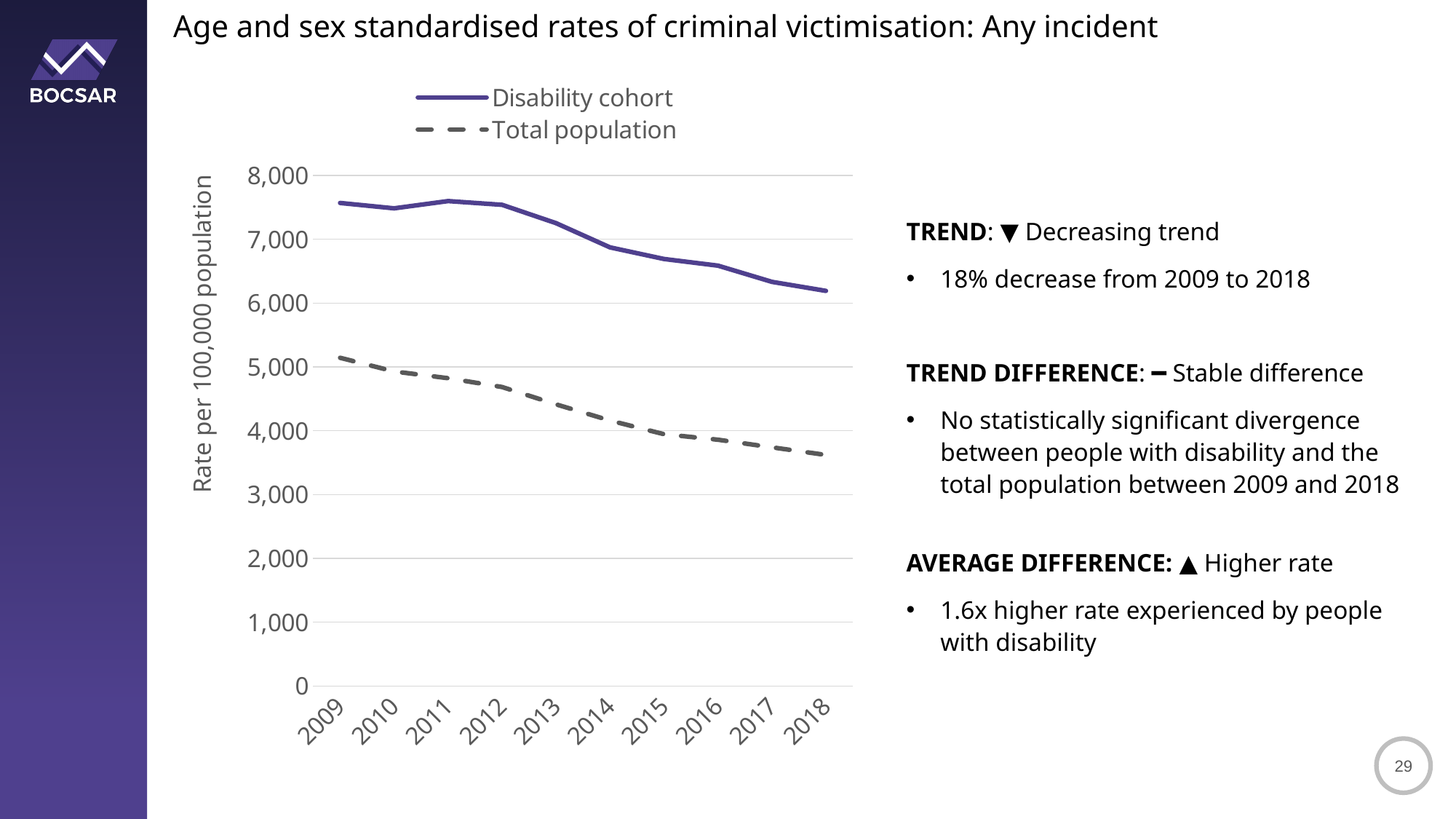
Is the value for the Total population in 2018 greater or less than 4,000? less In 2016, which series has the higher rate, Disability cohort or Total population? Disability cohort Does the Total population line rise or fall from 2009 to 2018? fall How many series does the legend list? 2 Is the value for the Disability cohort in 2012 greater or less than 7,000? greater Does the Disability cohort line rise or fall from 2009 to 2018? fall Is the value for the Disability cohort in 2009 greater or less than 7,000? greater What kind of chart is shown on the slide? line chart What is the label on the y axis? Rate per 100,000 population Which series is drawn with a dashed line? Total population How many years are plotted along the x axis? 10